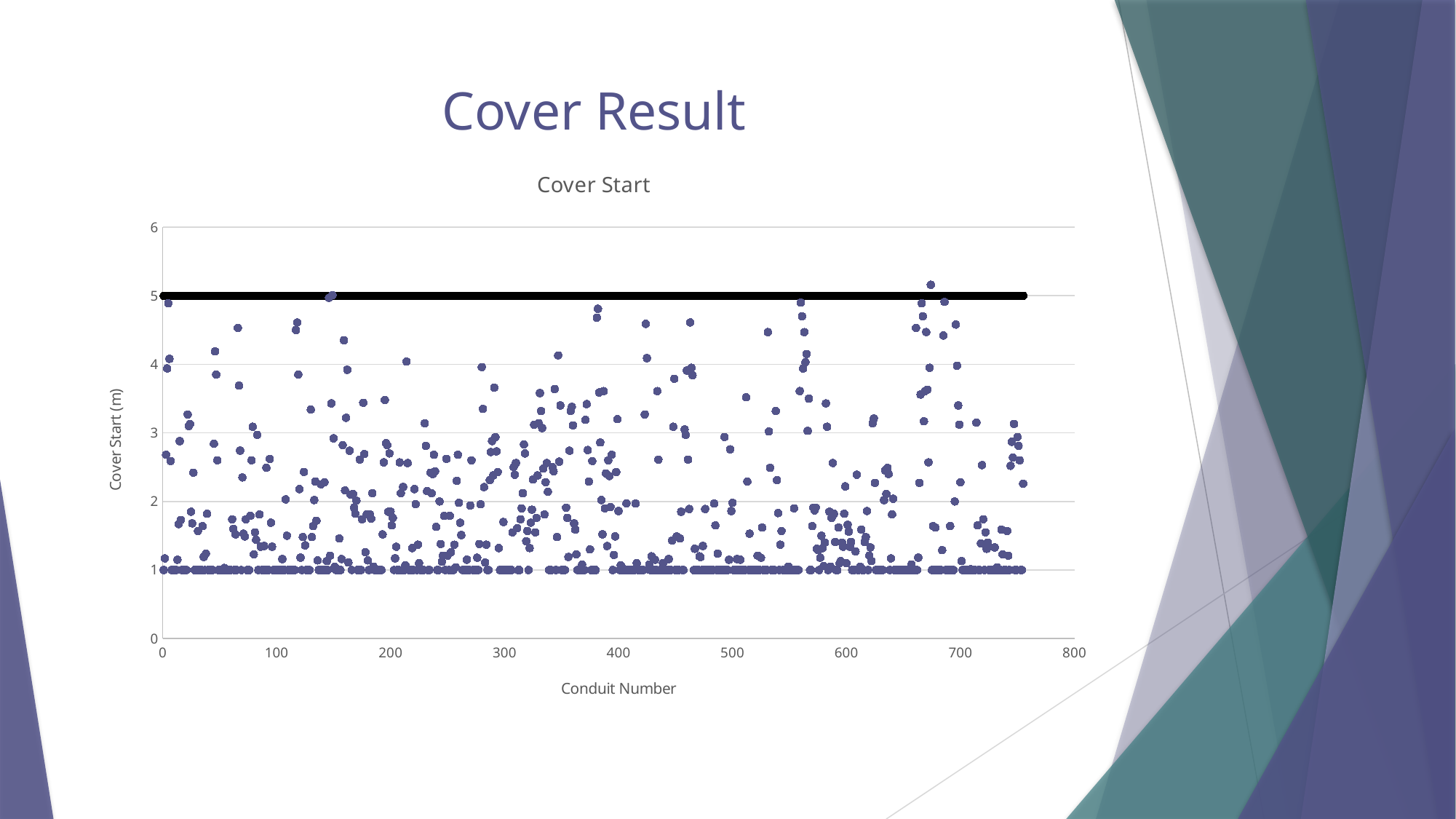
At what Cover Start value does the thick black horizontal line sit? 5 Is the highest plotted point greater or less than 5? greater Do the plotted Cover Start values show a clear rising or falling trend as Conduit Number increases? no clear trend What is the label on the y axis of the chart? Cover Start (m) Is the lowest plotted value greater or less than 2? less What is the title of the chart? Cover Start What is the maximum value shown on the y axis? 6 What kind of chart is shown on the slide? scatter chart What is the maximum value shown on the x axis (Conduit Number)? 800 Is the highest plotted point greater or less than 6? less At what Cover Start value do the largest number of points cluster along the bottom of the chart? 1